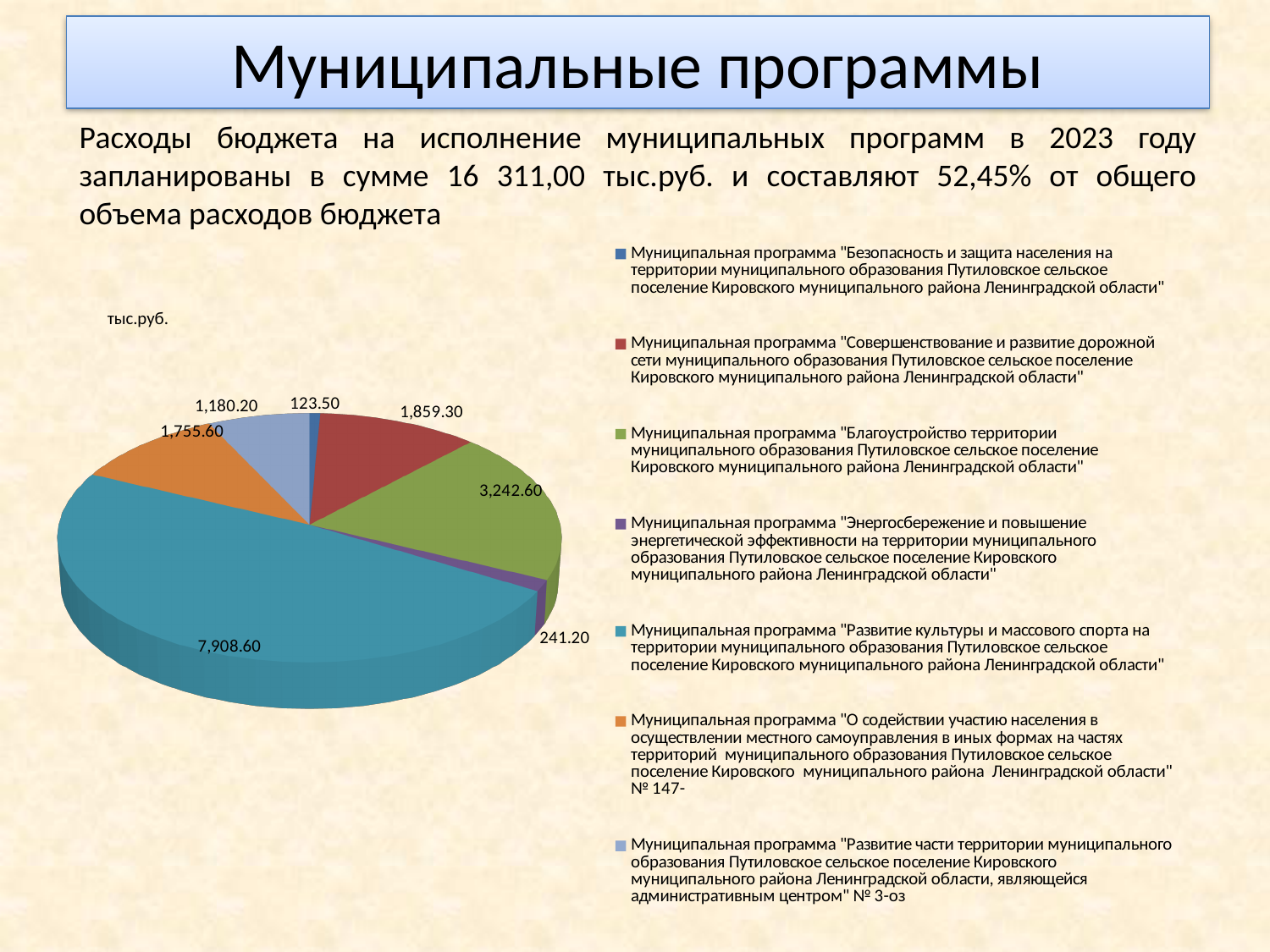
How many entries does the legend of the pie chart list? 7 What is the value for the municipal programme "Энергосбережение и повышение энергетической эффективности"? 241.20 Which municipal programme has the smallest slice of the pie? Безопасность и защита населения What is the difference between the values for "Благоустройство территории" and "Совершенствование и развитие дорожной сети"? 1,383.30 What unit label is shown above the pie chart? тыс.руб. What is the value for the municipal programme "Безопасность и защита населения"? 123.50 What kind of chart is shown on the slide? pie chart What is the value for the municipal programme "Благоустройство территории"? 3,242.60 Which municipal programme has the largest slice of the pie? Развитие культуры и массового спорта How many slices does the pie chart have? 7 What is the value for the municipal programme "Развитие культуры и массового спорта"? 7,908.60 Which is larger: the value for "Совершенствование и развитие дорожной сети" or for "Развитие части территории ... являющейся административным центром"? Совершенствование и развитие дорожной сети